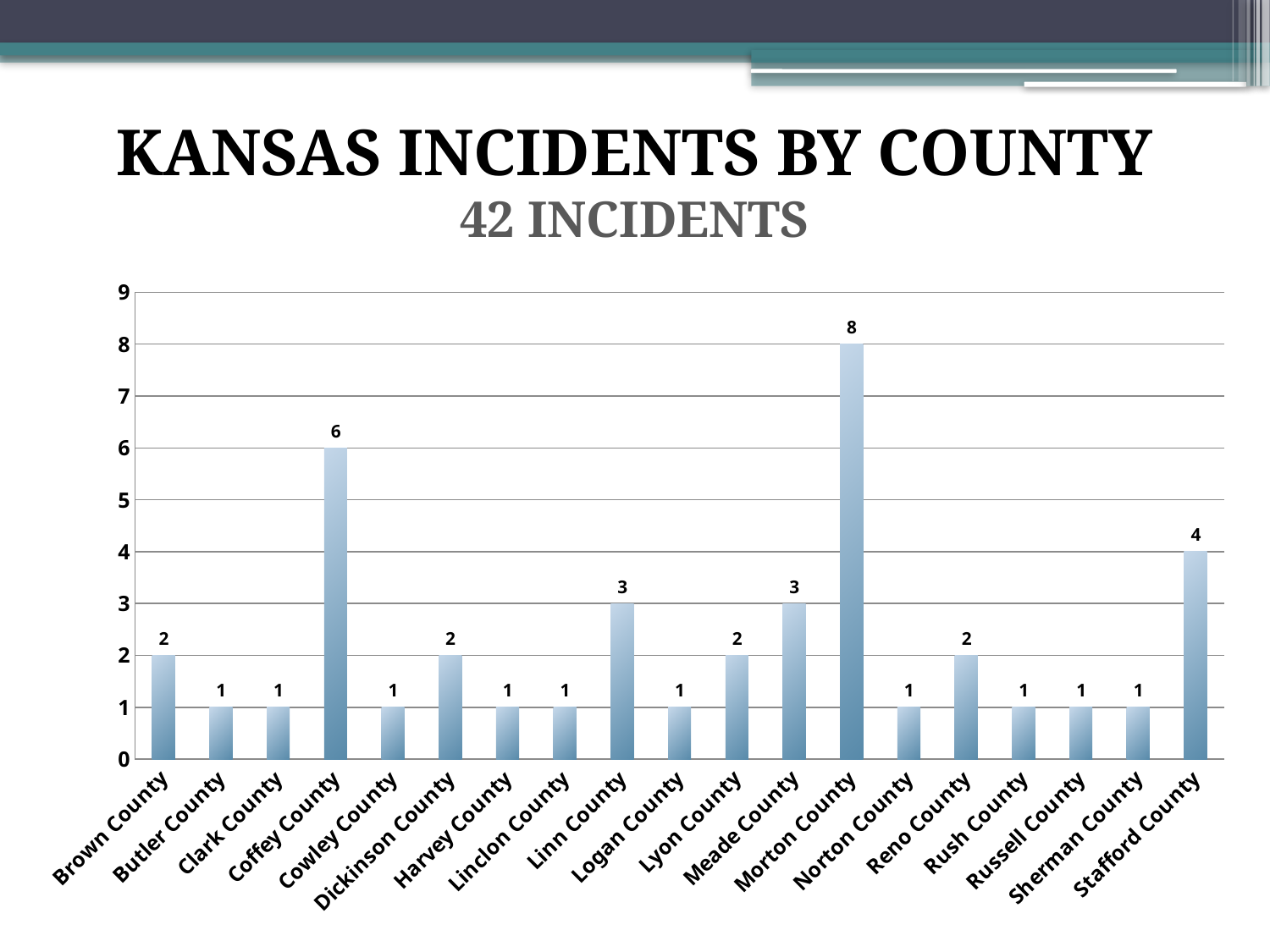
How many incidents does Stafford County have? 4 Which has more incidents, Linn County or Reno County? Linn County Which county has the highest number of incidents? Morton County What is the difference between the values for Morton County and Coffey County? 2 How many counties are shown on the x axis? 19 What is the difference between the values for Stafford County and Meade County? 1 What is the title of the chart? KANSAS INCIDENTS BY COUNTY What total number of incidents does the subtitle state? 42 INCIDENTS How many incidents are shown for Morton County? 8 What kind of chart is this? Bar chart What is the value for Coffey County? 6 Is the value for Morton County greater or less than 7? greater